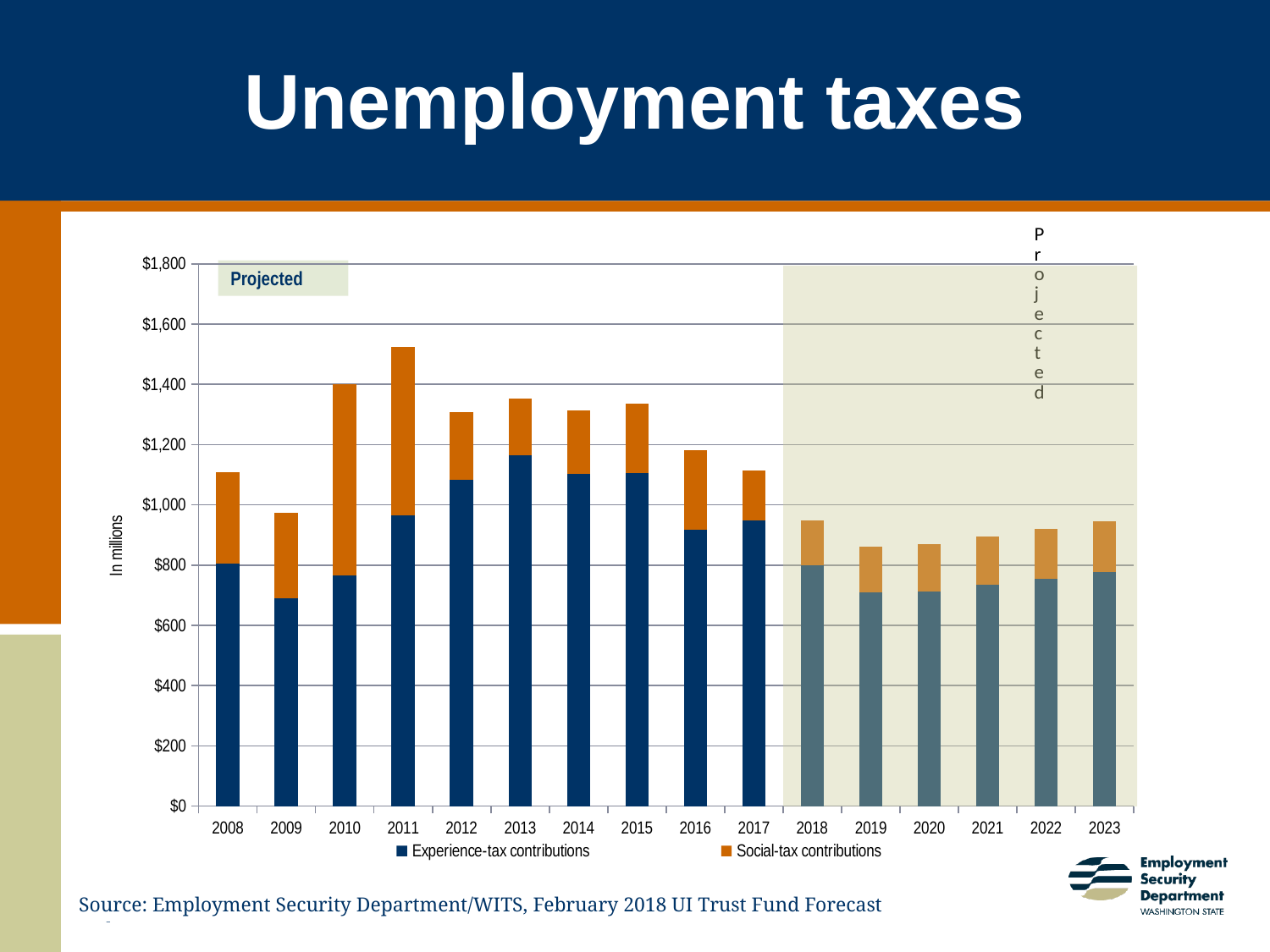
Is the experience-tax contribution for 2013 greater or less than $1,000? greater How many years are shown on the x axis of the chart? 16 Which year has the larger total contributions, 2011 or 2012? 2011 Is the total for 2019 greater or less than $1,000? less Which year has the larger total contributions, 2008 or 2009? 2008 What kind of chart is shown on the slide? Stacked bar chart How many series does the chart's legend list? 2 Is the total for 2011 greater or less than $1,400? greater What unit does the y-axis label say the values are in? In millions Which year has the highest total unemployment tax contributions? 2011 What are the two series named in the legend? Experience-tax contributions and Social-tax contributions